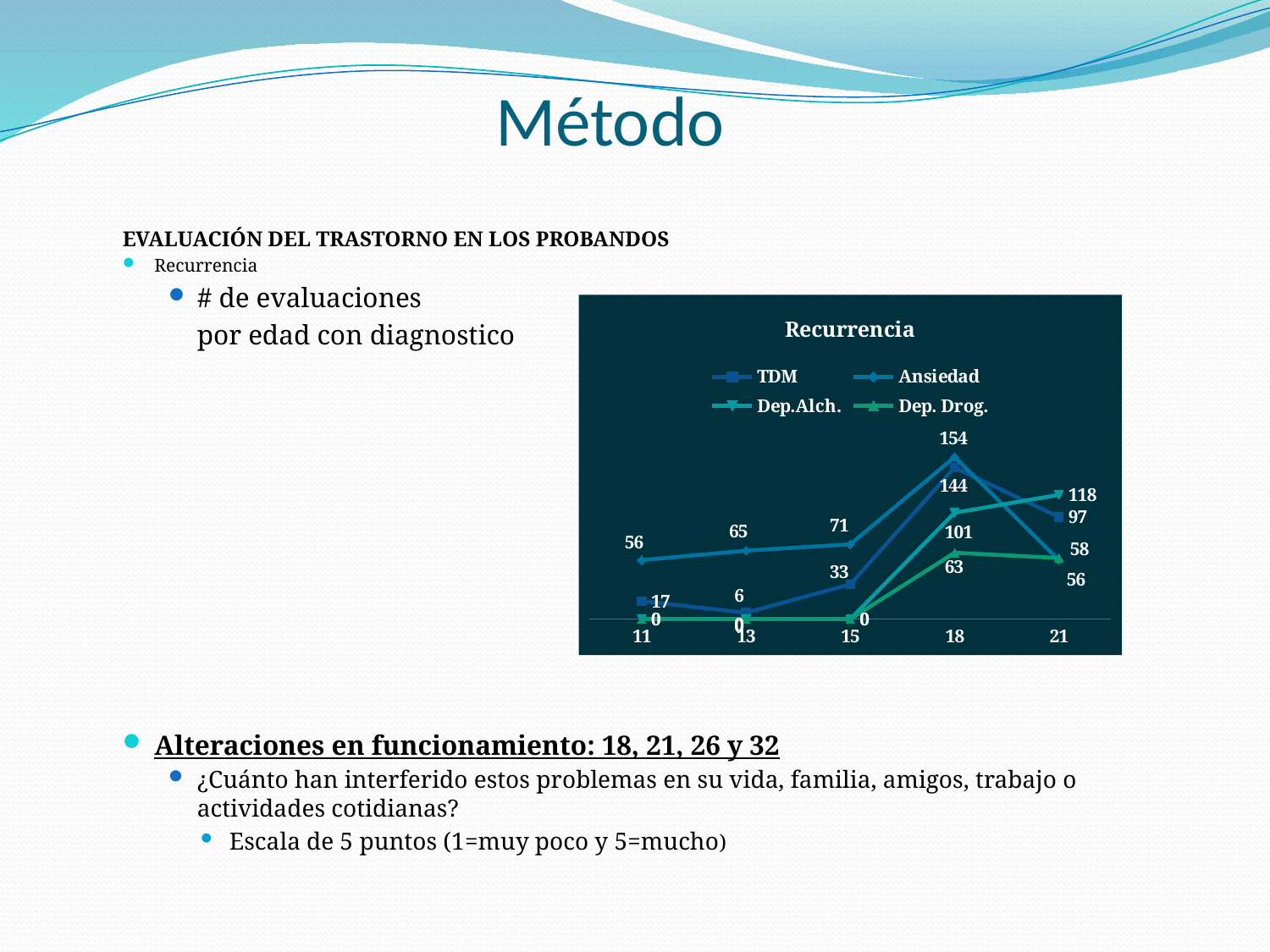
What is the value for TDM at age 13? 6 What is the highest value plotted on the chart? 154 What is the value for Dep.Alch. at age 21? 118 At age 21, which is larger: the value for Dep.Alch. or the value for TDM? Dep.Alch. How many series does the chart legend list? 4 What is the value for Ansiedad at age 15? 71 How many age points are shown on the x axis of the chart? 5 What is the value for Ansiedad at age 11? 56 What is the difference between the Ansiedad value and the TDM value at age 18? 10 What type of chart is shown on the slide? line chart What is the title of the chart? Recurrencia What is the value for TDM at age 18? 144